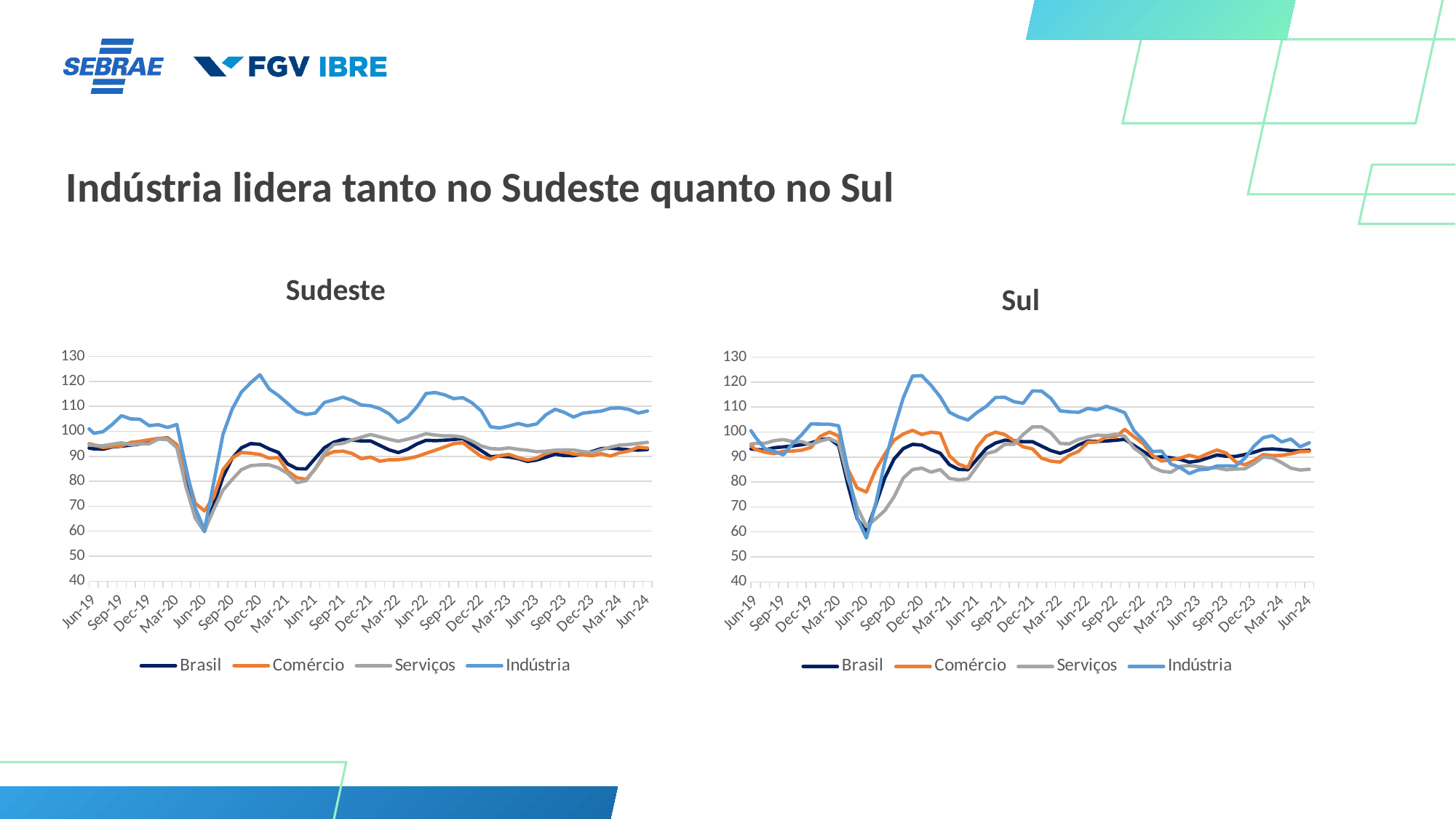
In the Sudeste chart, which series has the highest value at Jun-24? Indústria In the Sul chart, is the value for Indústria at Jun-20 greater or less than 70? less In the Sul chart, which series has the lowest value at Jun-24? Serviços In the Sudeste chart, does the Indústria line rise or fall between Mar-20 and Jun-20? fall In the Sul chart, is the value for Comércio at Jun-20 greater or less than 70? greater In the Sudeste chart, which series are listed in the legend? Brasil, Comércio, Serviços, Indústria What is the title of the slide? Indústria lidera tanto no Sudeste quanto no Sul How many series does the legend of the Sul chart list? 4 In the Sudeste chart, is the value for Indústria at Dec-20 greater or less than 110? greater What kind of chart is the Sudeste chart? line chart In the Sul chart, which is higher at Dec-20, Indústria or Serviços? Indústria